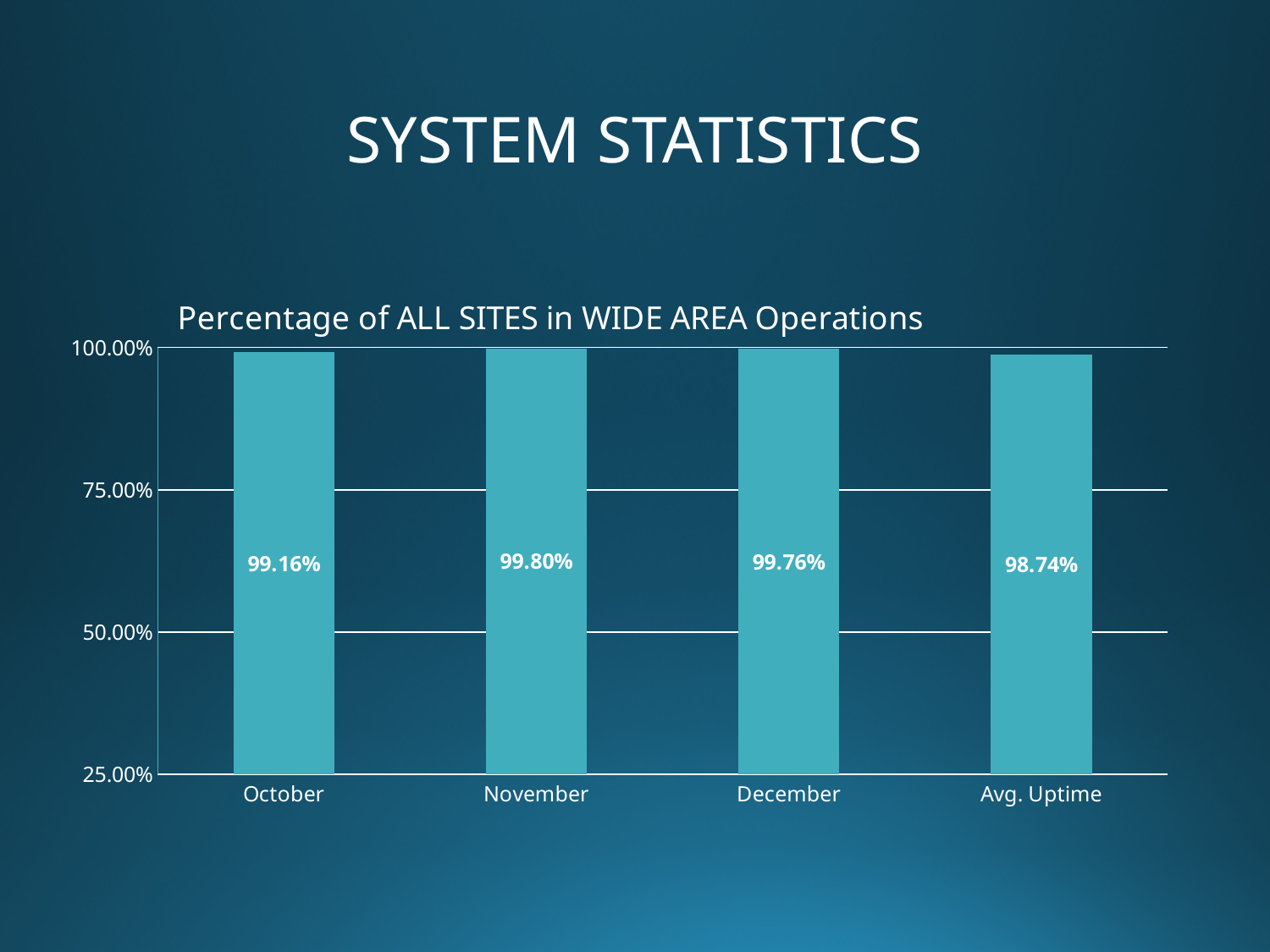
What is the difference between the values for November and October? 0.64% What kind of chart is shown on the slide? bar chart Which is larger, the value for November or the value for December? November What is the value for October? 99.16% What is the difference between the values for December and Avg. Uptime? 1.02% Which category has the highest value? November What is the title of the chart? Percentage of ALL SITES in WIDE AREA Operations How many categories are shown on the x axis? 4 What is the value for November? 99.80% What is the value for Avg. Uptime? 98.74% Is the value for Avg. Uptime greater or less than 75.00%? greater Which category has the lowest value? Avg. Uptime